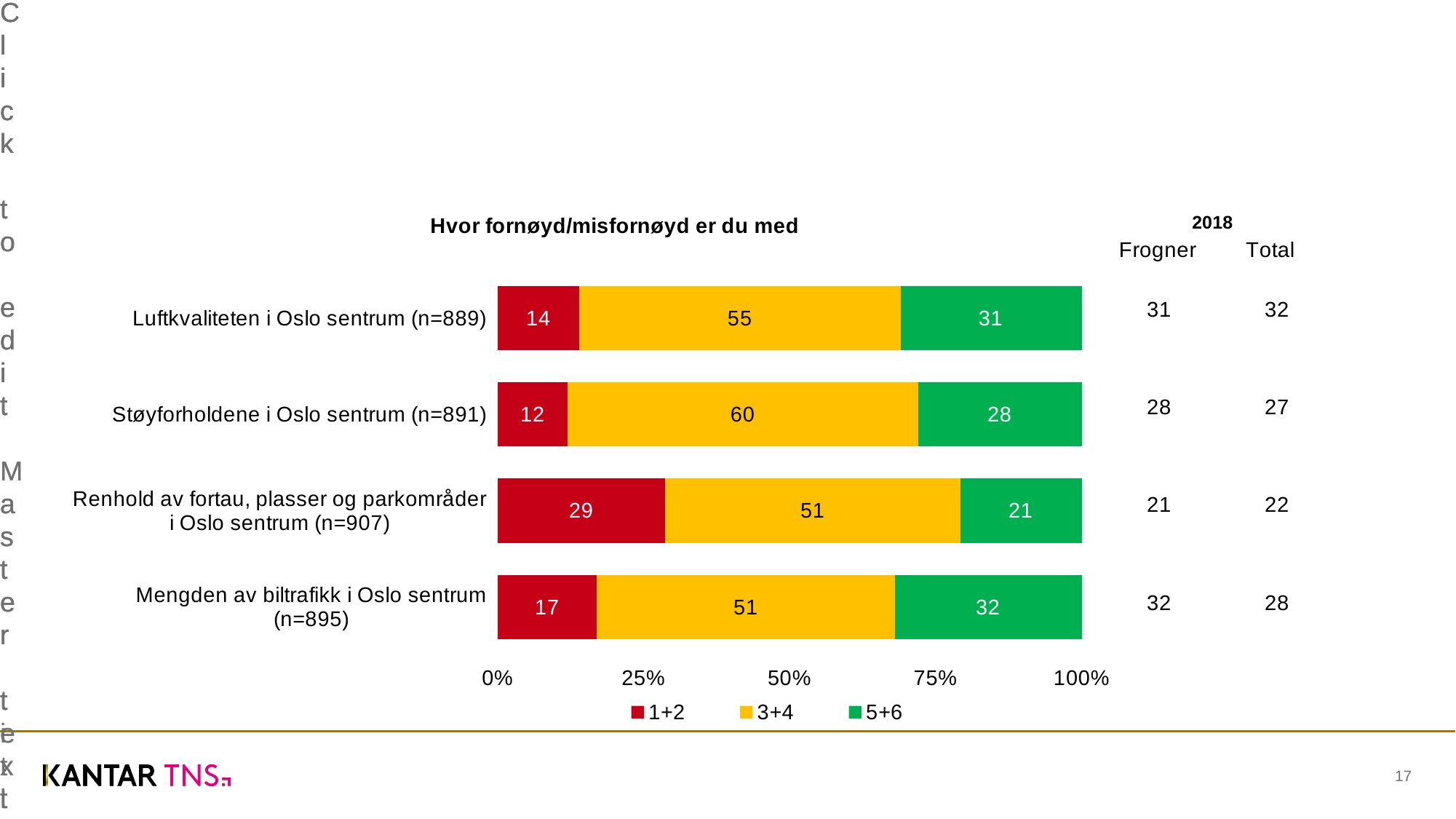
How many categories are shown on the chart? 4 How many series does the legend list? 3 What is the difference between the 3+4 values for "Støyforholdene i Oslo sentrum (n=891)" and "Renhold av fortau, plasser og parkområder i Oslo sentrum (n=907)"? 9 What is the title of the chart? Hvor fornøyd/misfornøyd er du med What is the total of the stacked bar for "Luftkvaliteten i Oslo sentrum (n=889)"? 100 Which category has the highest value for the 1+2 series? Renhold av fortau, plasser og parkområder i Oslo sentrum (n=907) What kind of chart is shown on the slide? Stacked bar chart Which is larger: the 1+2 value for "Mengden av biltrafikk i Oslo sentrum (n=895)" or the 1+2 value for "Støyforholdene i Oslo sentrum (n=891)"? Mengden av biltrafikk i Oslo sentrum (n=895) Which category has the lowest value for the 5+6 series? Renhold av fortau, plasser og parkområder i Oslo sentrum (n=907) What is the value of the 1+2 series for "Luftkvaliteten i Oslo sentrum (n=889)"? 14 What is the value of the 5+6 series for "Mengden av biltrafikk i Oslo sentrum (n=895)"? 32 What is the value of the 3+4 series for "Støyforholdene i Oslo sentrum (n=891)"? 60